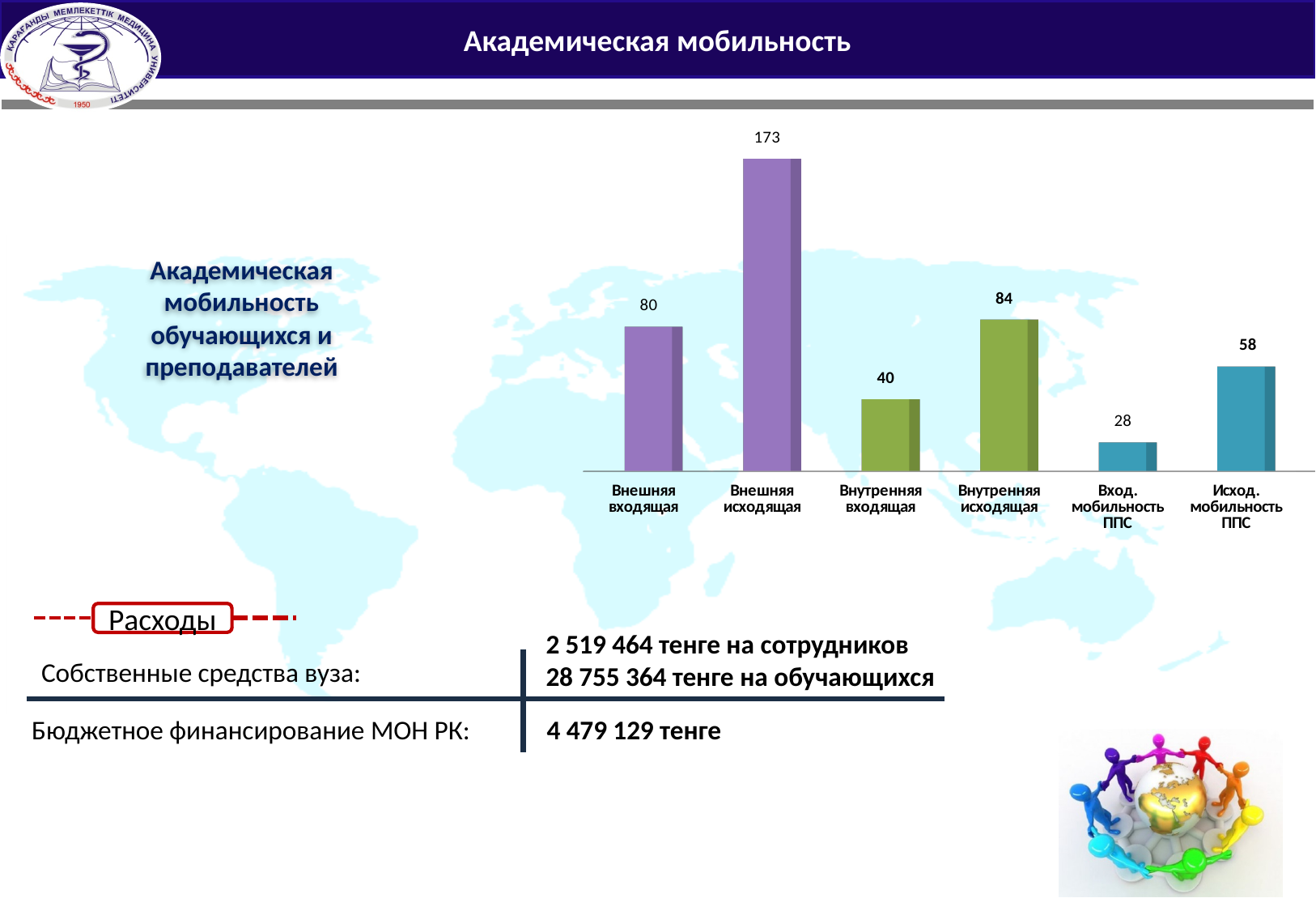
What kind of chart is shown on the slide? bar chart Which category has the lowest value? Вход. мобильность ППС What is the value for Внутренняя входящая? 40 What is the value for Внешняя исходящая? 173 What is the title text next to the chart? Академическая мобильность обучающихся и преподавателей Which category has the highest value? Внешняя исходящая What is the value for Вход. мобильность ППС? 28 What is the difference between Внутренняя исходящая and Внутренняя входящая? 44 What is the difference between Внешняя исходящая and Внешняя входящая? 93 Which is larger, Внешняя входящая or Внутренняя исходящая? Внутренняя исходящая How many categories are shown in the chart? 6 What is the value for Исход. мобильность ППС? 58